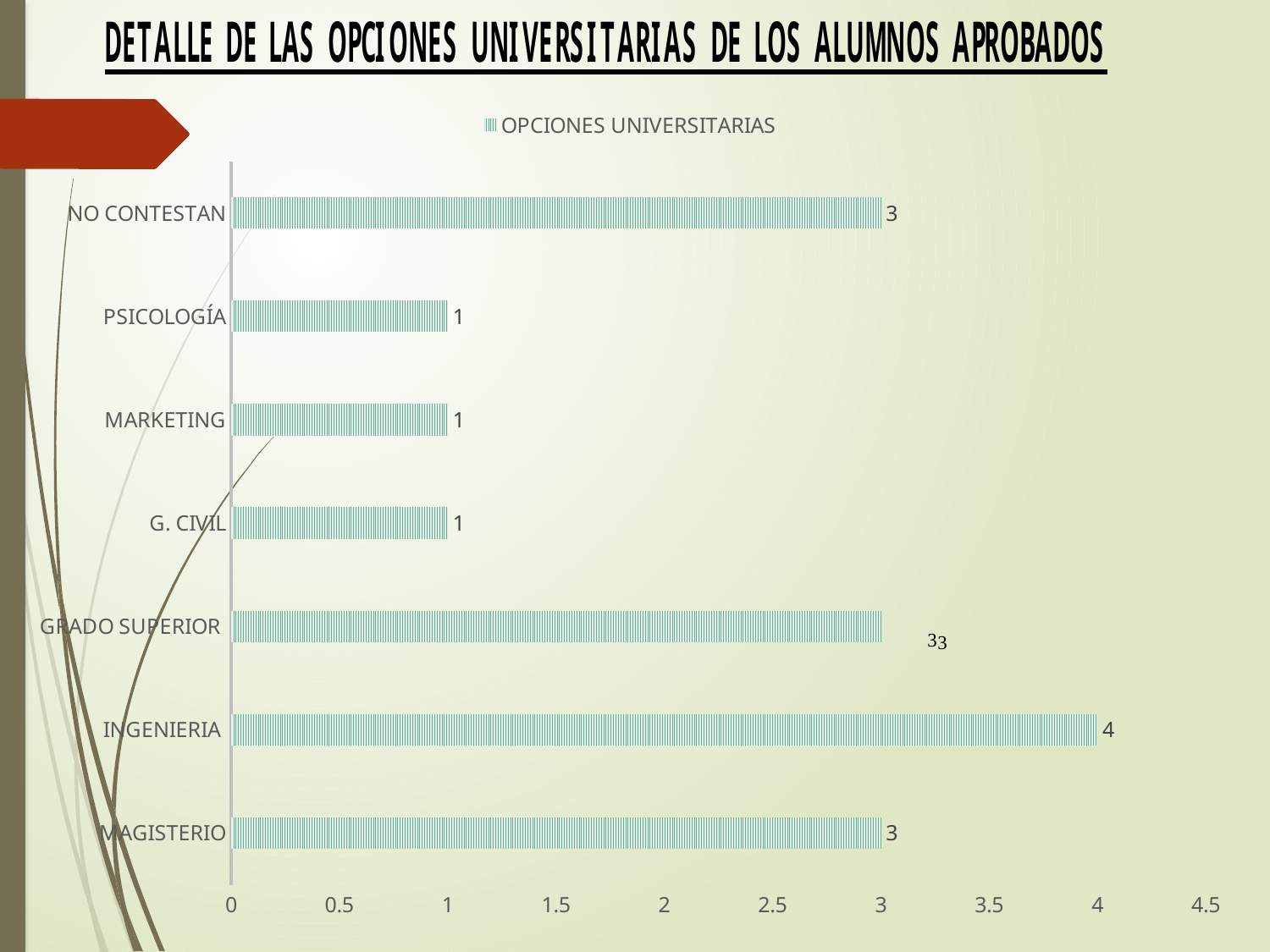
Which has a larger value, NO CONTESTAN or G. CIVIL? NO CONTESTAN What is the legend entry of the chart? OPCIONES UNIVERSITARIAS How many categories are shown in the chart? 7 What type of chart is shown on the slide? bar chart What is the value for MAGISTERIO? 3 What is the difference between the values for INGENIERIA and MARKETING? 3 Which category has the highest value? INGENIERIA What is the value for PSICOLOGÍA? 1 How many series does the legend list? 1 Is the value for GRADO SUPERIOR greater or less than 2? greater What is the value for INGENIERIA? 4 What is the value for NO CONTESTAN? 3